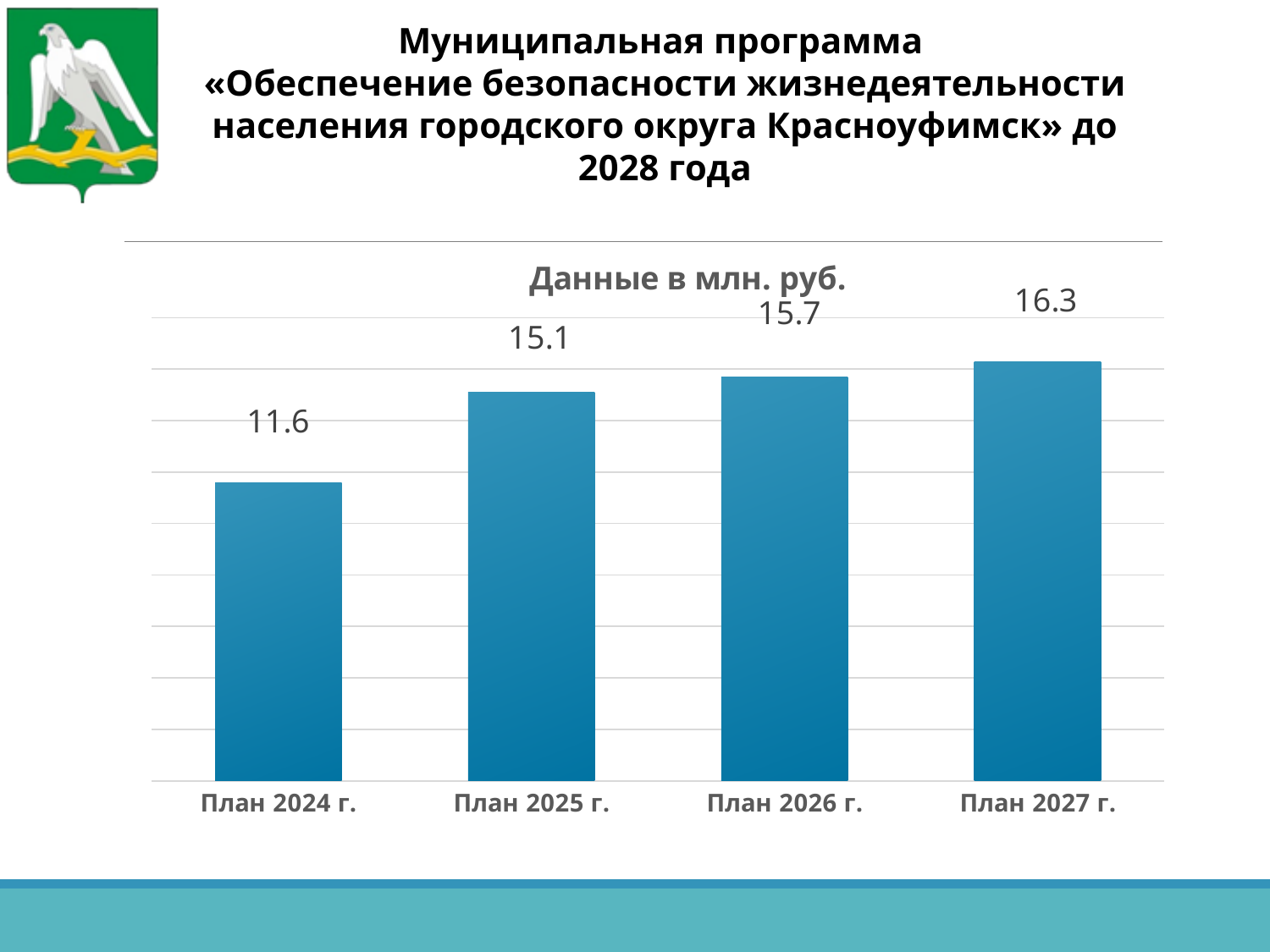
What is the difference between the values for План 2027 г. and План 2024 г.? 4.7 What is the value for План 2024 г.? 11.6 Which category has the highest value? План 2027 г. What is the value for План 2026 г.? 15.7 Do the values rise or fall from План 2024 г. to План 2027 г.? rise How many categories are shown on the chart? 4 What is the value for План 2027 г.? 16.3 Which is larger, the value for План 2025 г. or the value for План 2024 г.? План 2025 г. What is the value for План 2025 г.? 15.1 Which category has the lowest value? План 2024 г. What is the difference between the values for План 2026 г. and План 2025 г.? 0.6 What kind of chart is shown on the slide? bar chart